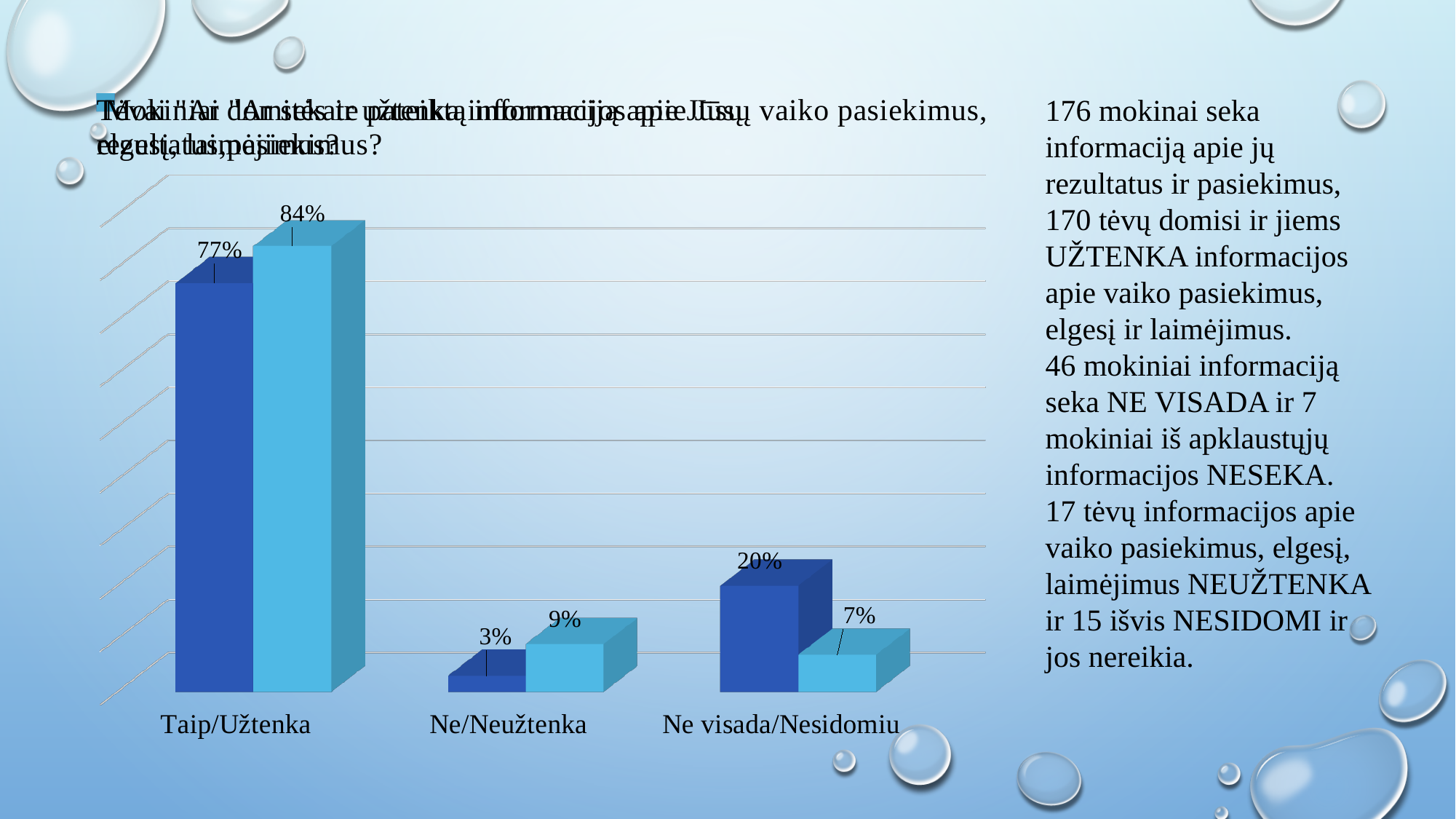
How many categories are shown on the x axis? 3 What is the value of the dark blue bar for Taip/Užtenka? 77% What is the value of the light blue bar for Ne/Neužtenka? 9% Which category has the lowest light blue bar? Ne visada/Nesidomiu For Ne visada/Nesidomiu, which bar is larger, the dark blue or the light blue? dark blue What is the difference between the light blue and dark blue bars for Taip/Užtenka? 7 percentage points What is the value of the dark blue bar for Ne visada/Nesidomiu? 20% What kind of chart is shown on the slide? bar chart Which category has the highest dark blue bar? Taip/Užtenka What is the value of the light blue bar for Taip/Užtenka? 84% What is the value of the dark blue bar for Ne/Neužtenka? 3% What is the value of the light blue bar for Ne visada/Nesidomiu? 7%